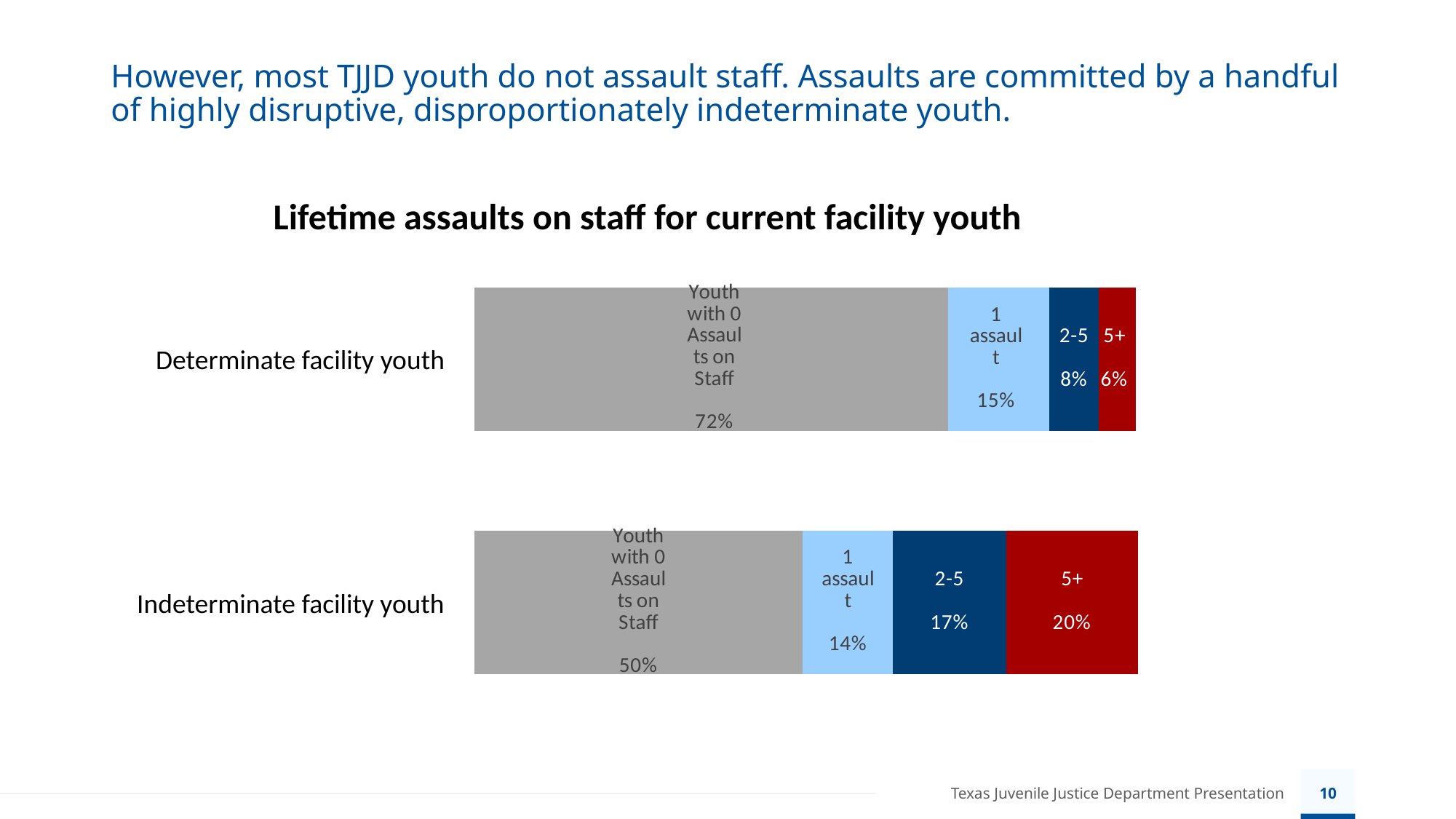
What is the title of the chart? Lifetime assaults on staff for current facility youth How many categories (bars) does the chart show? 2 What percentage of determinate facility youth have 2-5 assaults on staff? 8% Which segment is the smallest in the determinate facility youth bar? 5+ What is the difference between the 5+ assaults share for indeterminate facility youth and for determinate facility youth? 14% What percentage of determinate facility youth have 1 assault on staff? 15% What percentage of indeterminate facility youth have 0 assaults on staff? 50% What percentage of determinate facility youth have 0 assaults on staff? 72% What kind of chart is shown on the slide? Stacked bar chart How many segments make up each stacked bar? 4 What percentage of indeterminate facility youth have 5+ assaults on staff? 20% Which group has the larger share of youth with 2-5 assaults on staff, determinate or indeterminate facility youth? Indeterminate facility youth